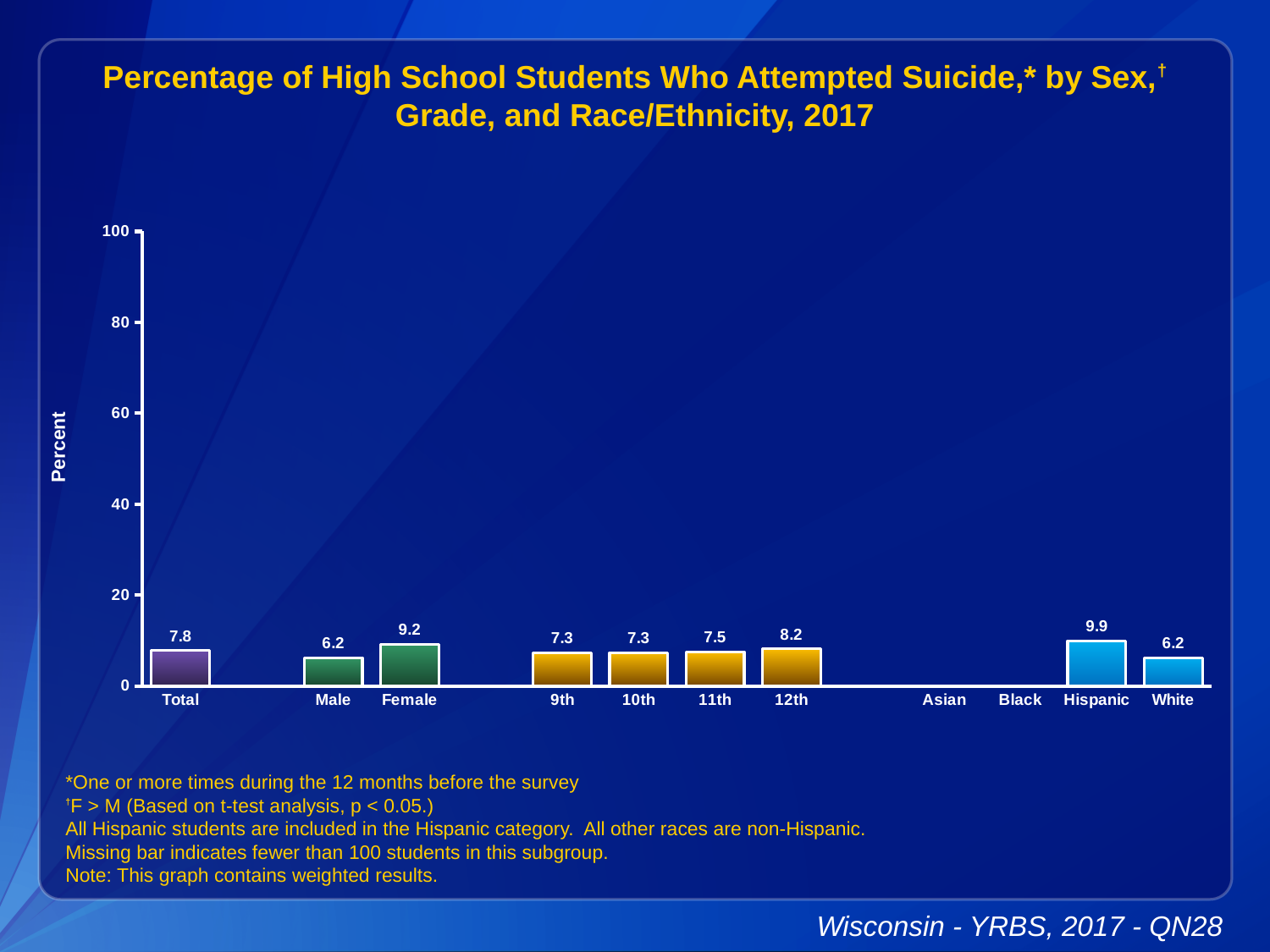
Which category has the highest value? Hispanic Which is larger, the value for 11th grade or the value for 9th grade? 11th Is the value for Female greater or less than 20? less What is the value for Total? 7.8 What kind of chart is shown? bar chart Do the values rise or fall from 9th grade to 12th grade? rise What is the value for Hispanic? 9.9 What is the value for Female? 9.2 What is the difference between the Female and Male values? 3.0 Which categories have no bar shown? Asian and Black What is the value for 12th grade? 8.2 How many categories are labelled on the x axis? 11